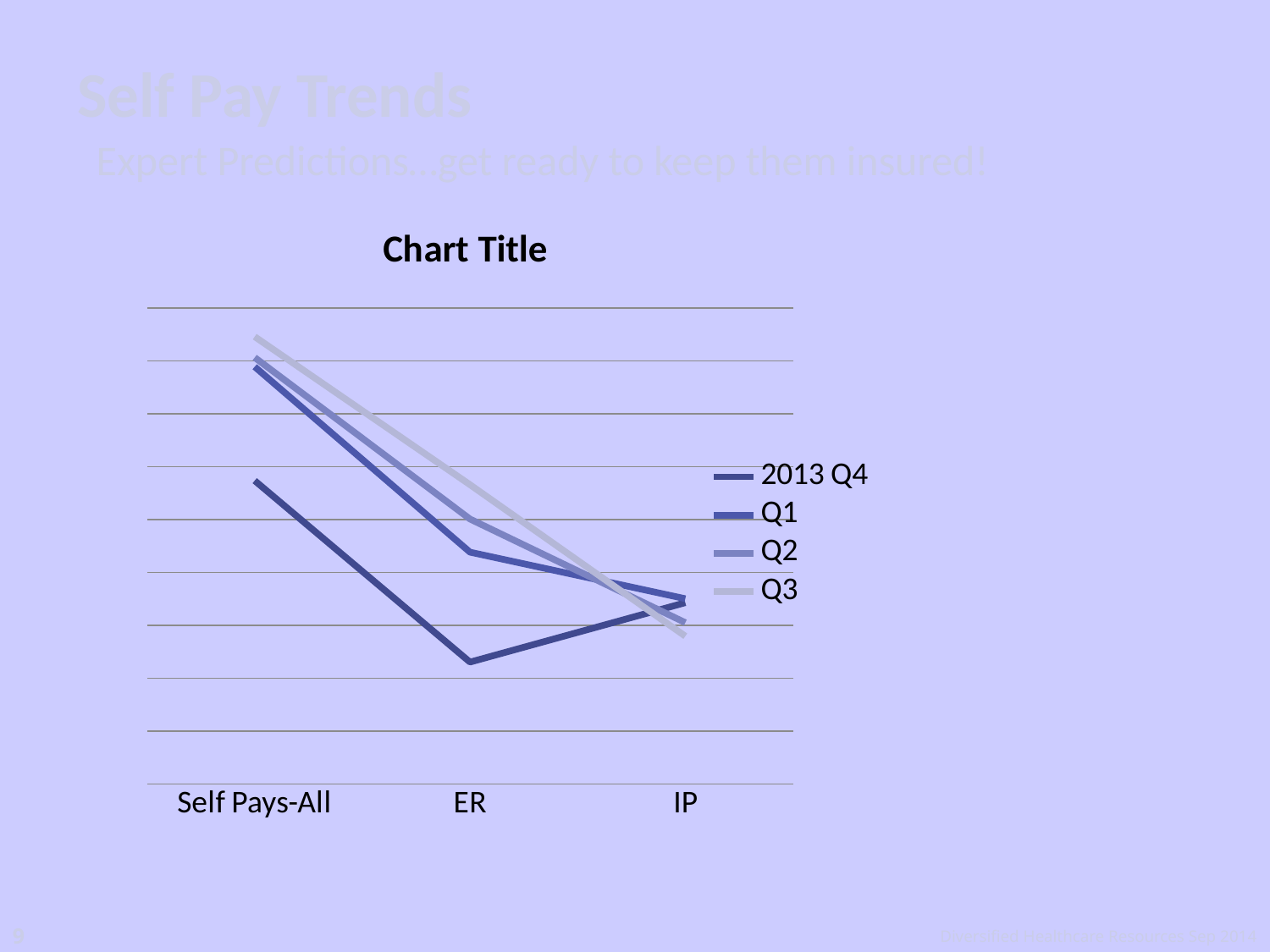
How many series does the chart's legend list? 4 Which series has the highest value at Self Pays-All? Q3 How many categories are shown on the x axis of the chart? 3 Does the Q3 line rise or fall from Self Pays-All to IP? fall What kind of chart is shown on the slide? line chart Does the 2013 Q4 line rise or fall from ER to IP? rise Which series has the lowest value at Self Pays-All? 2013 Q4 Which series are listed in the chart's legend? 2013 Q4, Q1, Q2, Q3 Which series has the highest value at ER? Q3 What is the title of the chart? Chart Title Does the 2013 Q4 line rise or fall from Self Pays-All to ER? fall Which series has the lowest value at ER? 2013 Q4